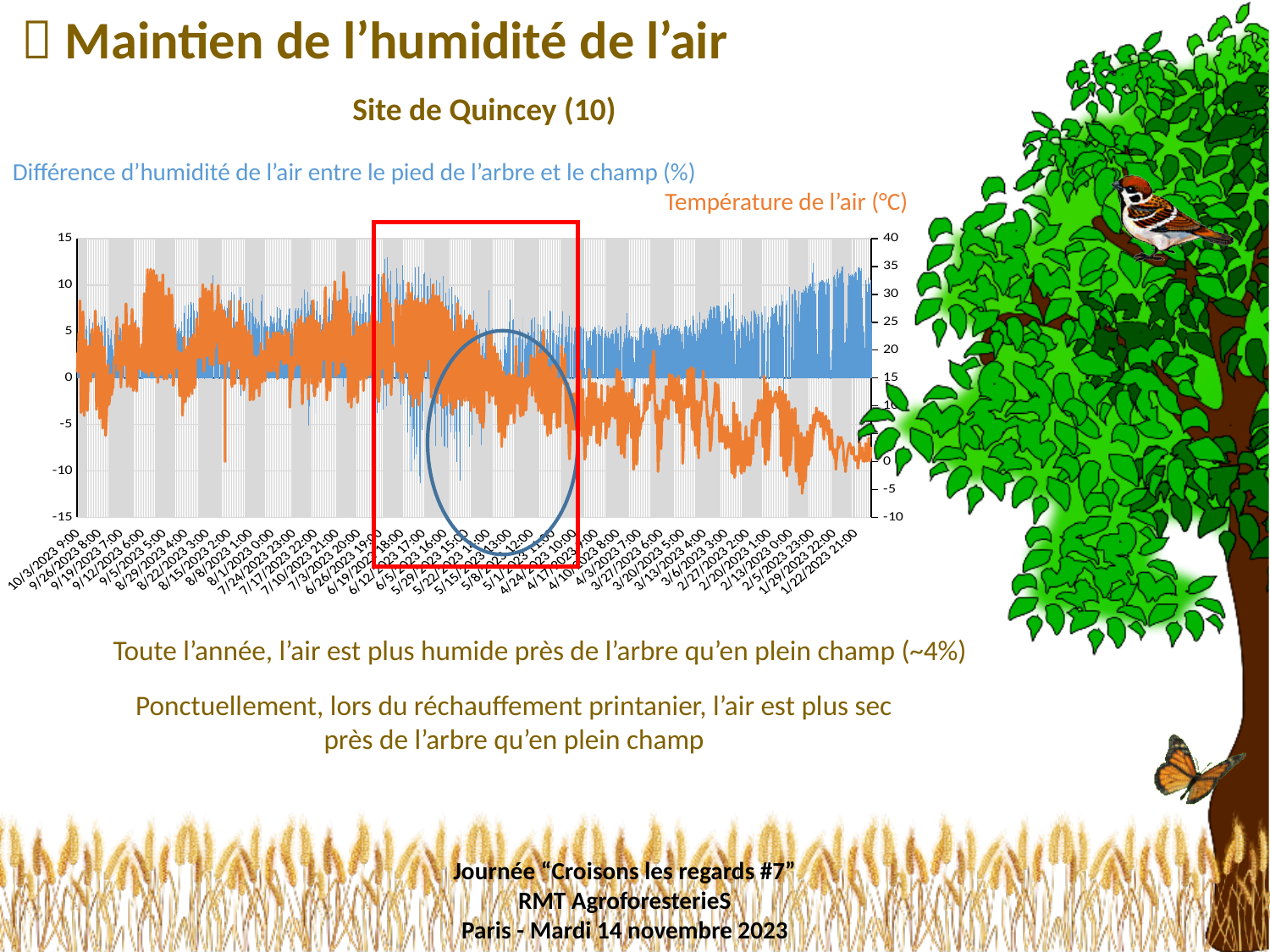
Does the orange temperature series generally rise or fall from left to right along the x axis? fall What kind of chart is shown on the slide? line chart Which colour is used for the 'Température de l'air (°C)' series? orange How many data series are plotted on the chart? 2 What is the maximum value shown on the right-hand (temperature) axis? 40